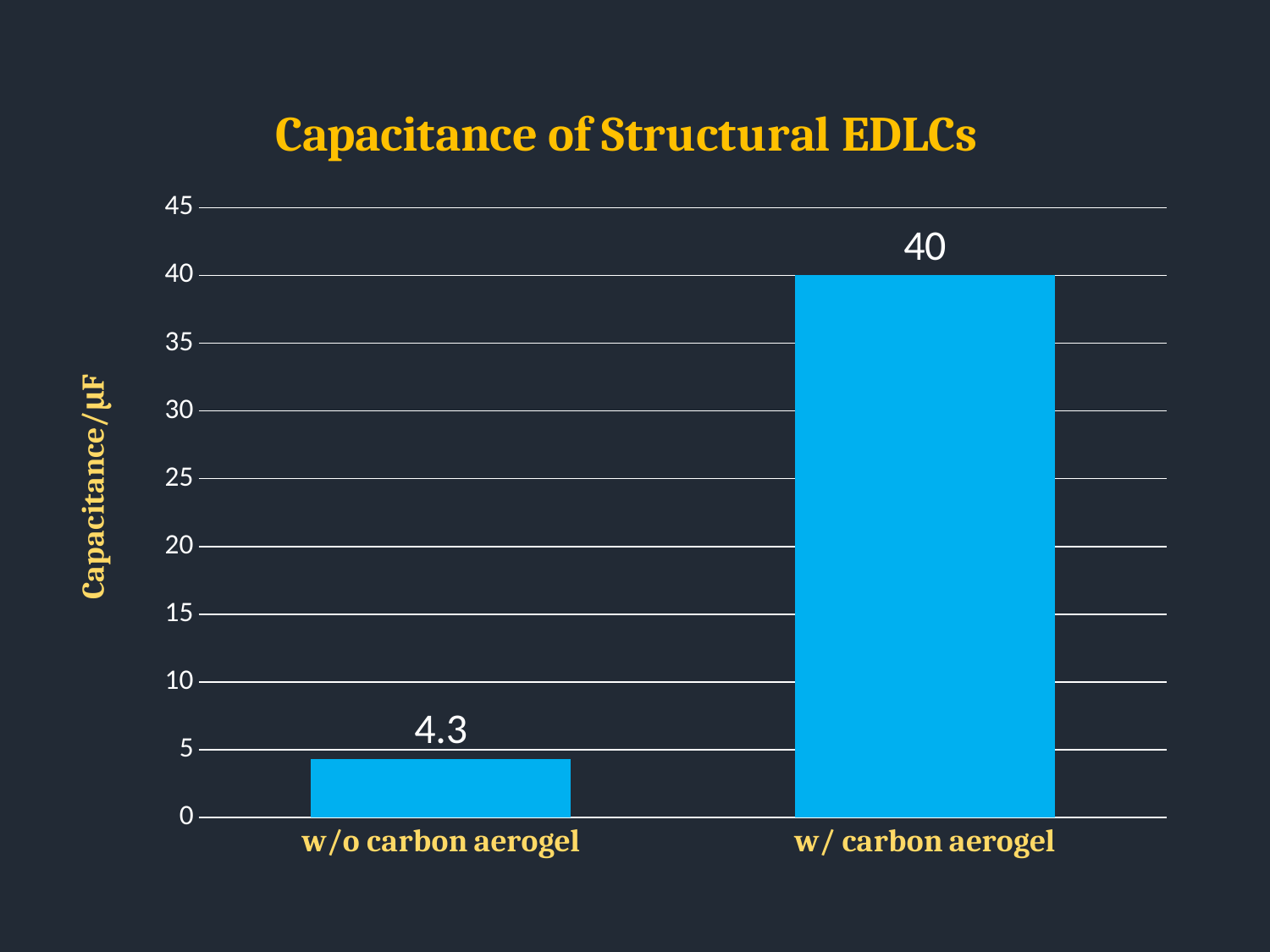
Is the value for w/o carbon aerogel greater or less than 5? less What is the title of the chart? Capacitance of Structural EDLCs What kind of chart is shown on the slide? bar chart Is the value for w/ carbon aerogel greater or less than 35? greater Which is larger, the capacitance w/ carbon aerogel or w/o carbon aerogel? w/ carbon aerogel What is the difference in capacitance between w/ carbon aerogel and w/o carbon aerogel? 35.7 What is the capacitance for w/ carbon aerogel? 40 What is the label of the vertical axis? Capacitance/μF Which category has the lowest capacitance? w/o carbon aerogel How many categories are shown on the chart? 2 What is the capacitance for w/o carbon aerogel? 4.3 Which category has the highest capacitance? w/ carbon aerogel